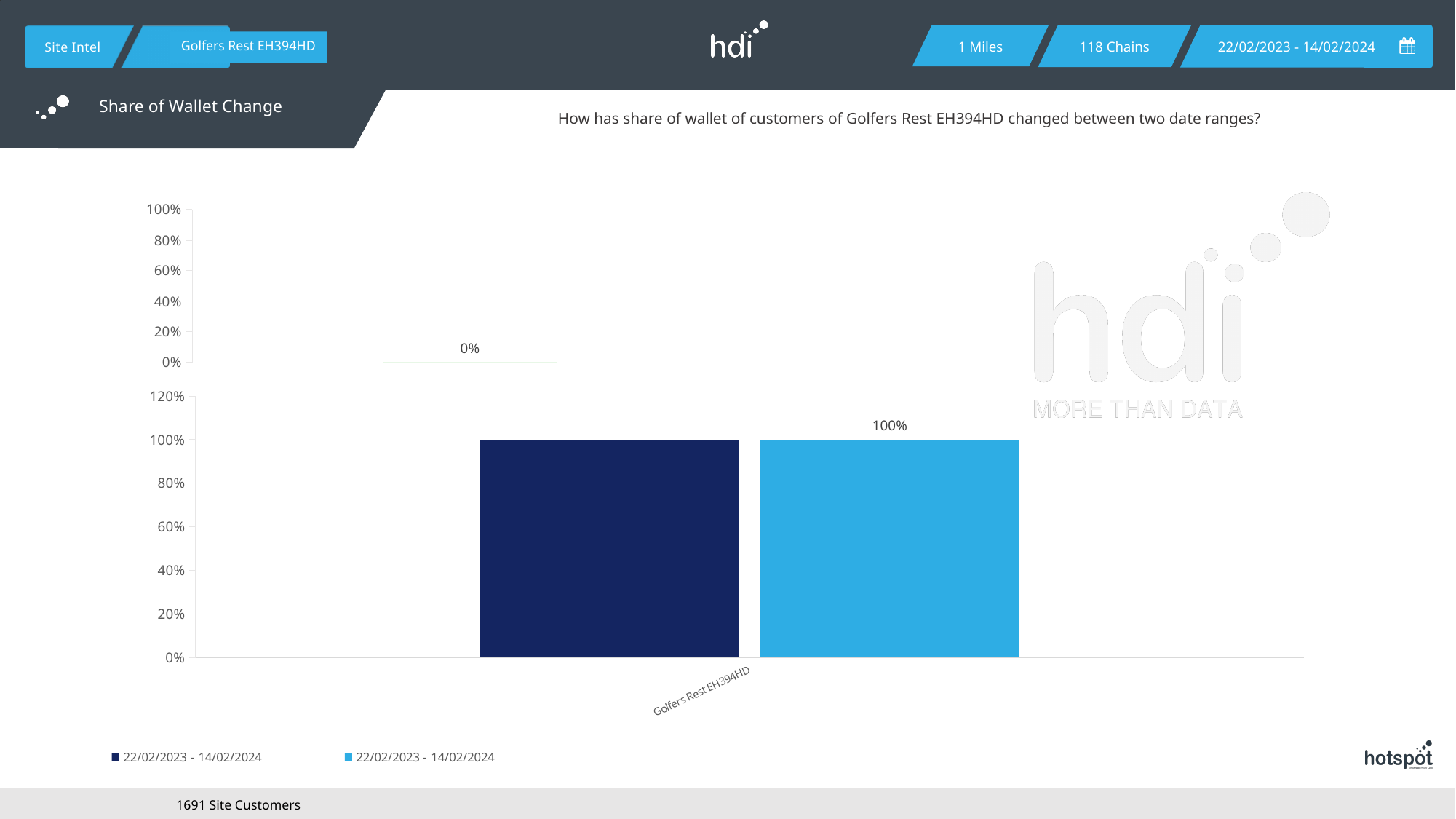
On the bottom chart, how many categories are shown on the x axis? 1 On the bottom chart, what is the category label shown on the x axis? Golfers Rest EH394HD On the bottom chart, what is the difference between the dark blue bar and the light blue bar for Golfers Rest EH394HD? 0% On the bottom chart, what value does the dark blue bar for Golfers Rest EH394HD reach on the y axis? 100% On the bottom chart, what is the highest tick value shown on the y axis? 120% On the top chart, is the plotted value greater or less than 20%? less On the top chart, what value does the data label show? 0% How many series does the legend at the bottom of the slide list? 2 What kind of chart is the bottom chart? bar chart On the bottom chart, is the value of the dark blue bar greater or less than 80%? greater On the bottom chart, is the light blue bar higher than, lower than, or equal to the dark blue bar? equal On the bottom chart, what is the value shown by the data label above the light blue bar for Golfers Rest EH394HD? 100%